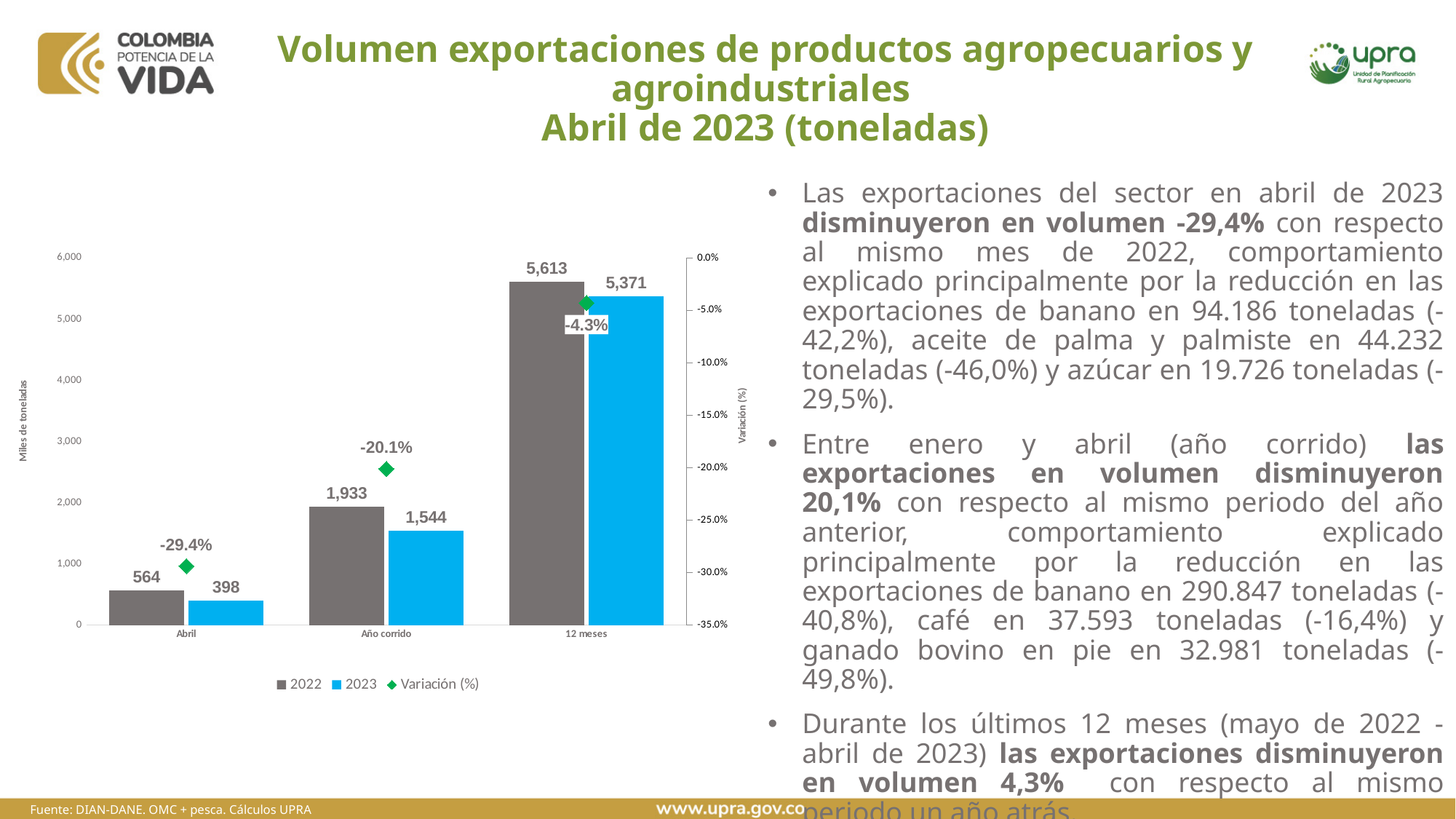
How many series does the legend list? 3 What is the difference between the 2022 and 2023 values for 12 meses? 242 What kind of chart is shown on the slide? Bar chart with a marker series for Variación (%) What is the Variación (%) value for 12 meses? -4.3% Which category has the highest 2022 value? 12 meses What is the 2022 value for Abril? 564 What is the 2023 value for Año corrido? 1,544 What is the difference between the 2022 and 2023 values for Abril? 166 Which is larger for Año corrido, the 2022 value or the 2023 value? 2022 How many categories are shown on the x axis? 3 What is the 2023 value for 12 meses? 5,371 Which category has the lowest 2023 value? Abril